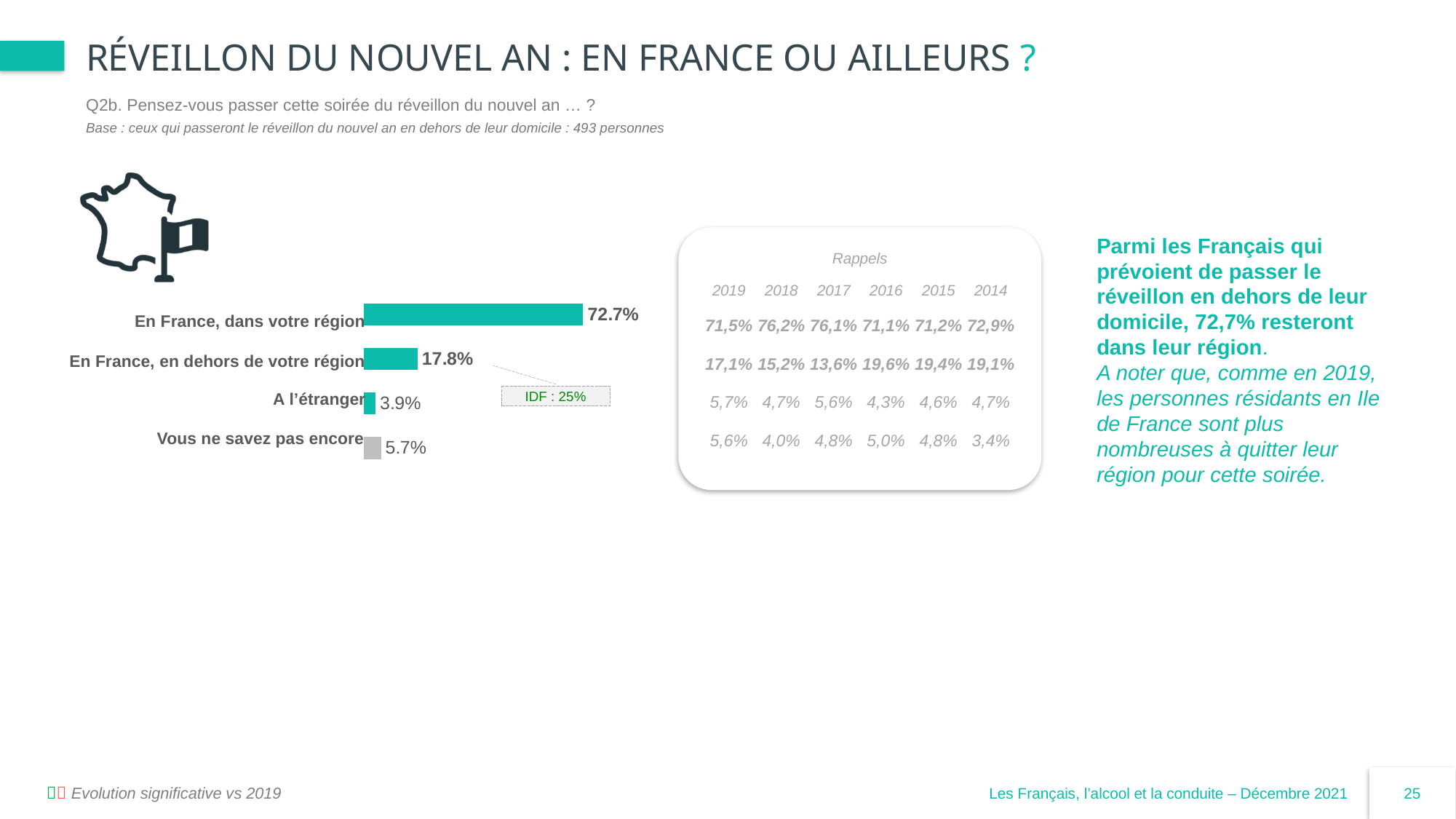
What is the value for "Vous ne savez pas encore"? 5.7% How many categories does the bar chart show? 4 What is the value for "A l'étranger"? 3.9% Which category has the lowest value? A l'étranger Which category has the highest value? En France, dans votre région Which is larger: "Vous ne savez pas encore" or "A l'étranger"? Vous ne savez pas encore What kind of chart is shown on the slide? Bar chart What is the value for "En France, en dehors de votre région"? 17.8% What value is shown in the callout box labelled "IDF" next to the "En France, en dehors de votre région" bar? 25% What is the difference between "En France, dans votre région" and "En France, en dehors de votre région"? 54.9% What is the difference between "Vous ne savez pas encore" and "A l'étranger"? 1.8% What is the value for "En France, dans votre région"? 72.7%